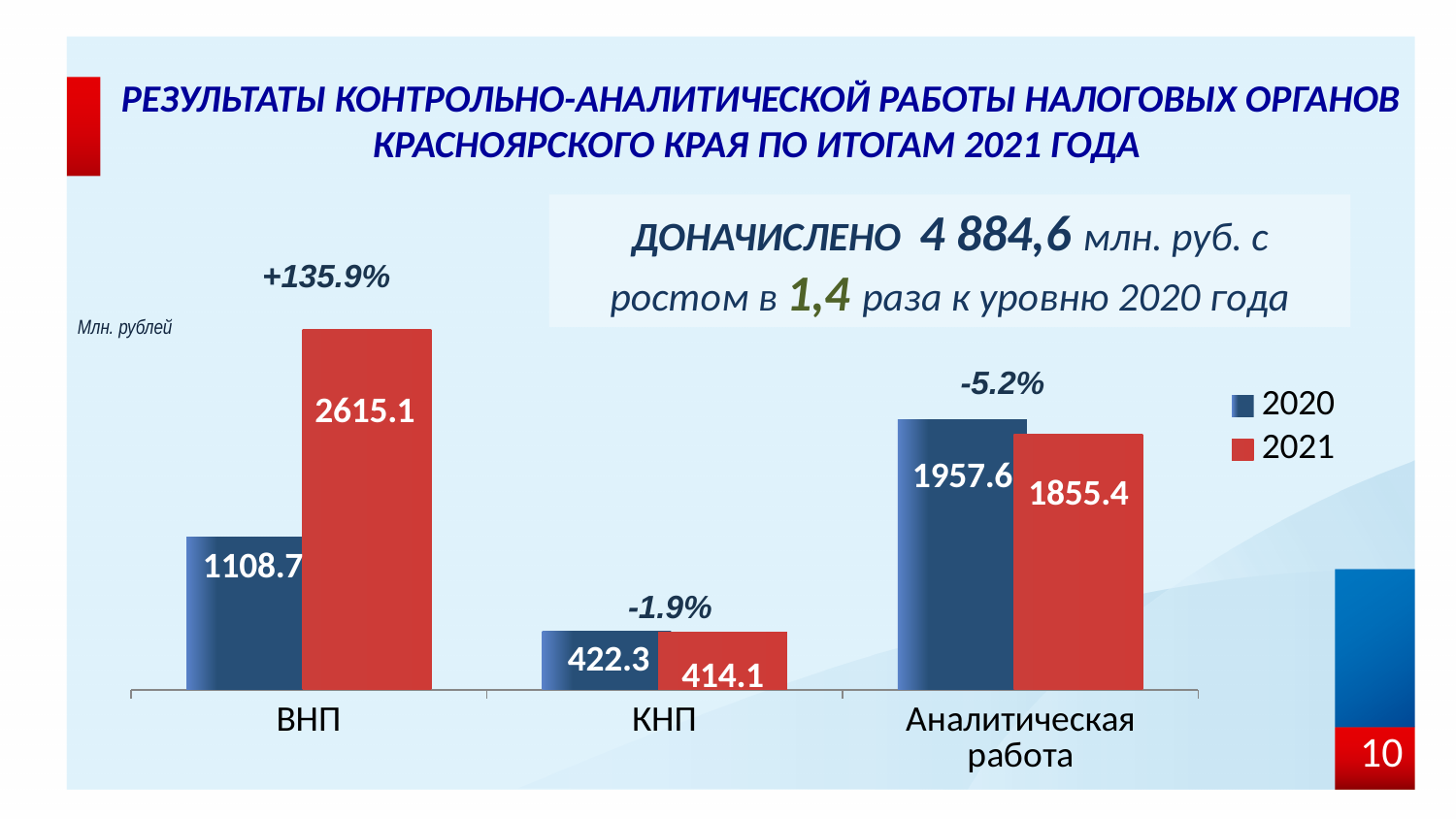
What is the value for Аналитическая работа in the 2020 series? 1957.6 Which category has the lowest value in the 2020 series? КНП What is the difference between the 2021 and 2020 values for ВНП? 1506.4 How many categories are shown on the x axis of the chart? 3 How many series does the legend list? 2 Which is larger for КНП: the 2020 value or the 2021 value? 2020 What kind of chart is shown on the slide? Bar chart Which category has the highest value in the 2021 series? ВНП What is the difference between the 2020 and 2021 values for Аналитическая работа? 102.2 What is the value for ВНП in the 2021 series? 2615.1 What percentage change is shown above the ВНП bars? +135.9% What is the value for КНП in the 2021 series? 414.1